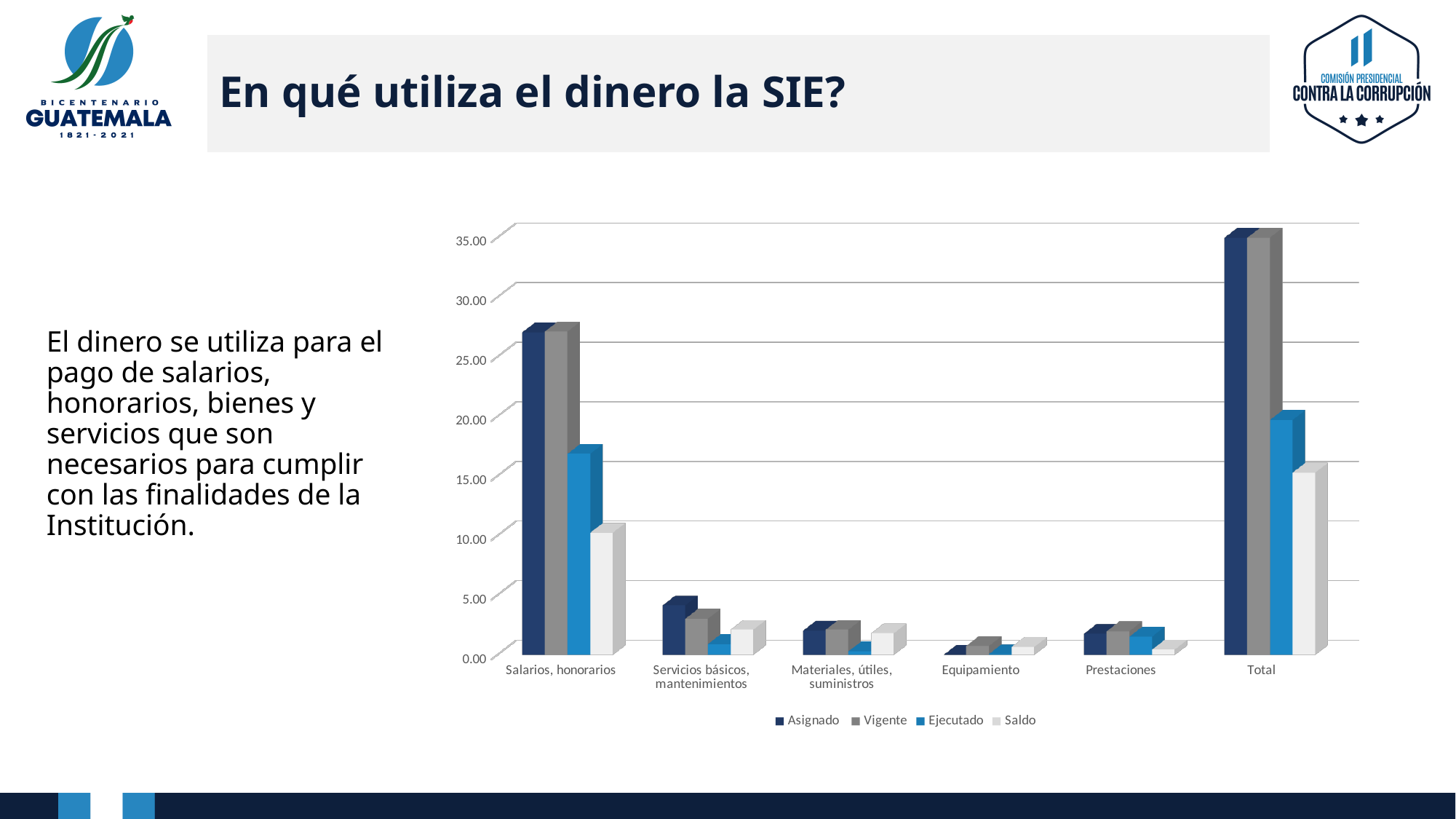
Which category has the highest Asignado value? Total Is the Asignado value for Total greater or less than 30.00? greater Is the Saldo value for Total greater or less than 10.00? greater Which is larger: the Asignado value for Servicios básicos, mantenimientos or the Asignado value for Materiales, útiles, suministros? Servicios básicos, mantenimientos Is the Asignado value for Salarios, honorarios greater or less than 25.00? greater How many categories are shown on the x axis of the chart? 6 What are the four series names listed in the chart legend? Asignado, Vigente, Ejecutado, Saldo For Salarios, honorarios, which is larger: the Asignado value or the Ejecutado value? Asignado How many series does the chart legend list? 4 Which category has the lowest Asignado value? Equipamiento What kind of chart is shown on the slide? Bar chart